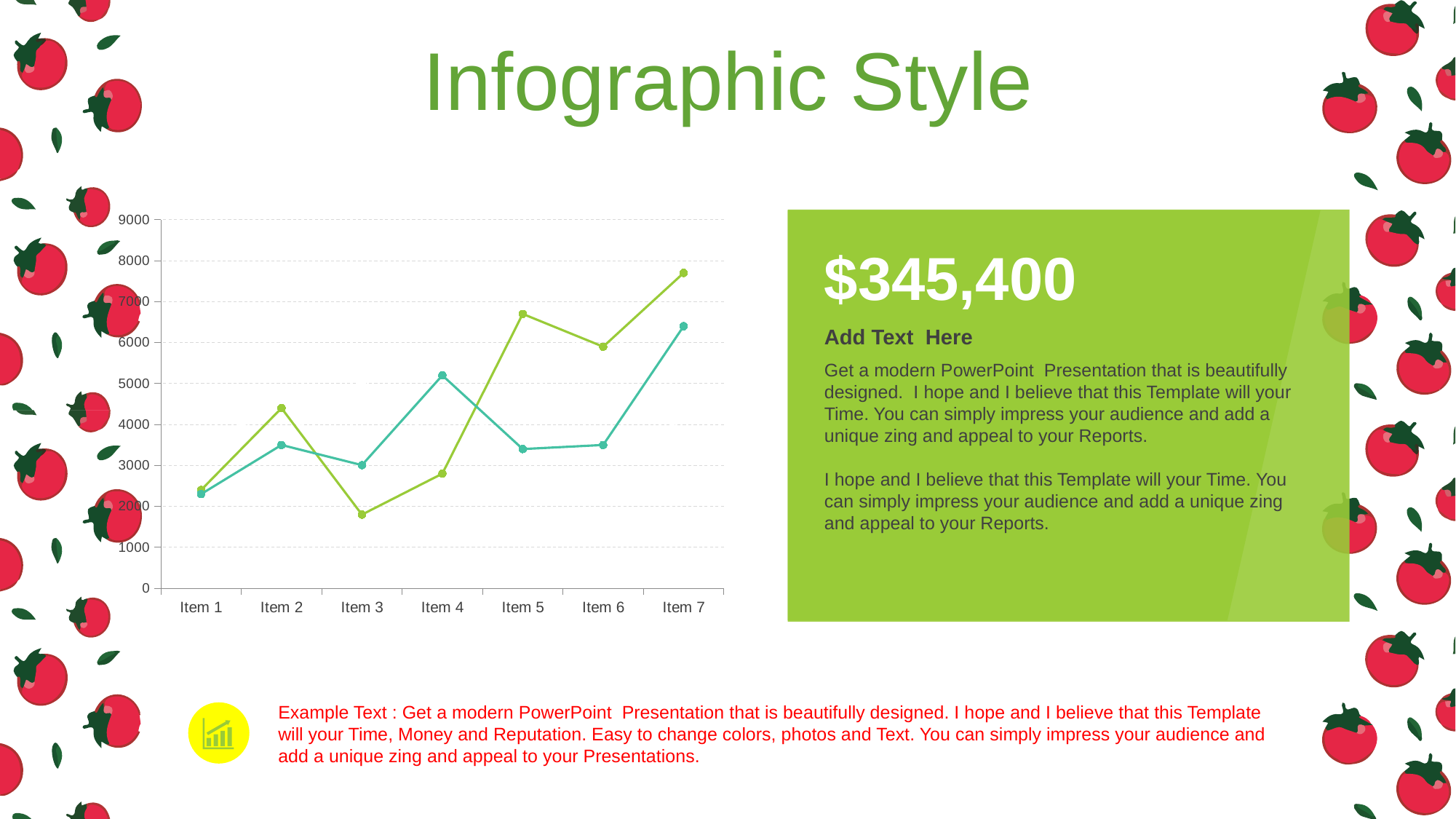
For the teal line, which item has the lowest value? Item 1 For the light green line, which item has the highest value? Item 7 At Item 4, which line has the higher value, the light green line or the teal line? the teal line How many lines are plotted on the chart? 2 Is the value of the light green line at Item 5 greater or less than 6000? greater How many categories are shown on the x axis of the chart? 7 At Item 2, which line has the higher value, the light green line or the teal line? the light green line Is the value of the teal line at Item 4 greater or less than 4000? greater What kind of chart is shown on the slide? line chart For the light green line, which item has the lowest value? Item 3 For the teal line, which item has the highest value? Item 7 Is the value of the light green line at Item 3 greater or less than 2000? less